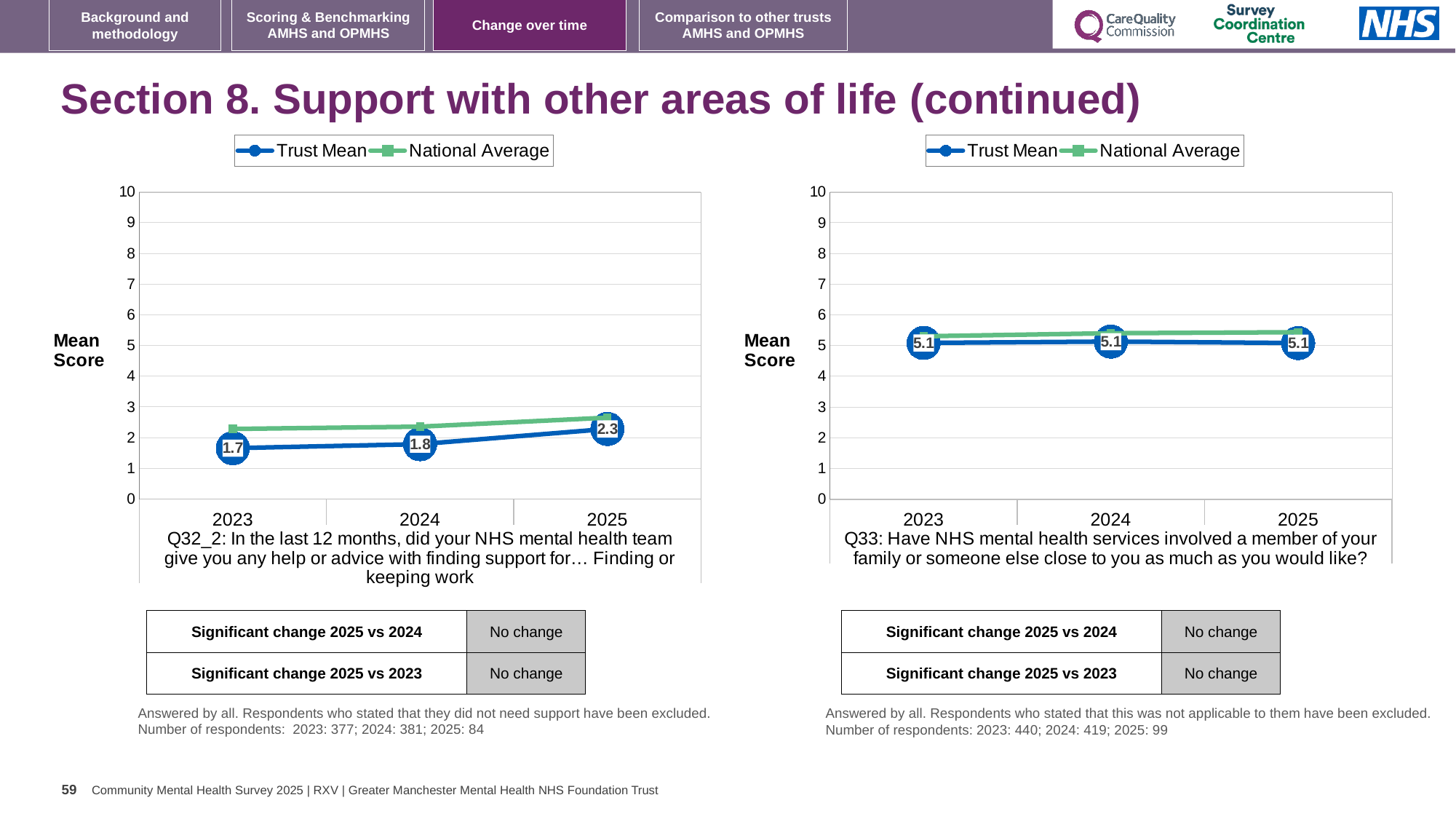
In the right chart (Q33), does the Trust Mean rise, fall or stay flat from 2023 to 2025? stay flat In the left chart (Q32_2), which is larger in 2025, the Trust Mean or the National Average? National Average In the left chart (Q32_2), which year has the lowest Trust Mean? 2023 In the right chart (Q33), what is the Trust Mean for 2024? 5.1 In the left chart (Q32_2), what is the Trust Mean for 2023? 1.7 In the left chart (Q32_2), what is the Trust Mean for 2025? 2.3 How many series does the legend of the right chart (Q33) list? 2 In the left chart (Q32_2), is the National Average for 2023 greater or less than 3? less In the right chart (Q33), is the National Average for 2025 greater or less than 5? greater In the left chart (Q32_2), does the Trust Mean rise or fall from 2023 to 2025? rise In the left chart (Q32_2), what is the difference between the Trust Mean for 2025 and 2023? 0.6 In the left chart (Q32_2), which year has the highest Trust Mean? 2025